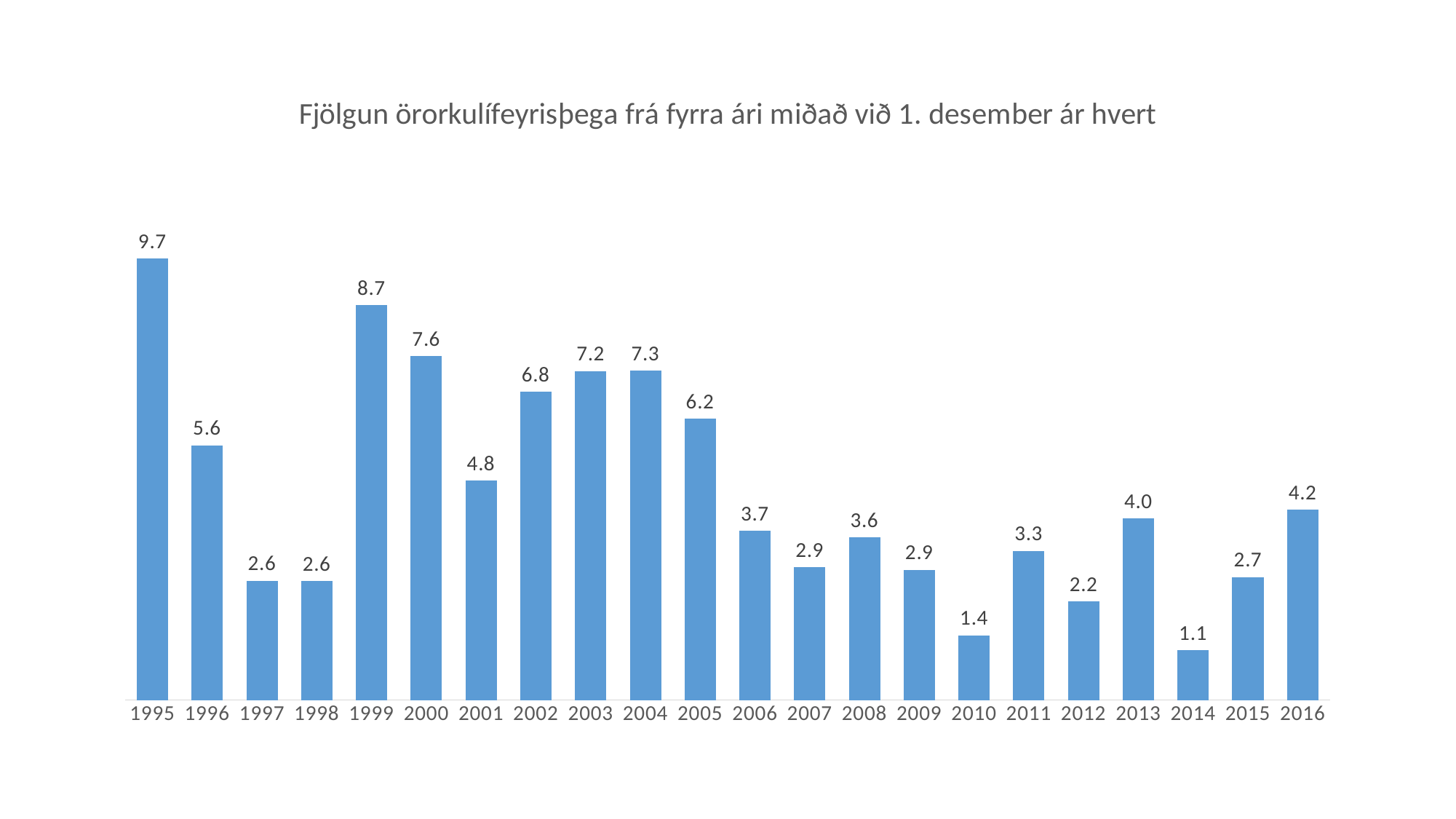
What kind of chart is this? Bar chart What is the title of the chart? Fjölgun örorkulífeyrisþega frá fyrra ári miðað við 1. desember ár hvert What is the value for 2010? 1.4 What is the difference between the values for 1999 and 2000? 1.1 What is the value for 1995? 9.7 Which year has the highest value? 1995 How many years are shown on the x axis? 22 What is the value for 2016? 4.2 What is the difference between the values for 2013 and 2014? 2.9 Which is larger, the value for 2006 or the value for 2008? 2006 Which year has the lowest value? 2014 Which is larger, the value for 2003 or the value for 2004? 2004